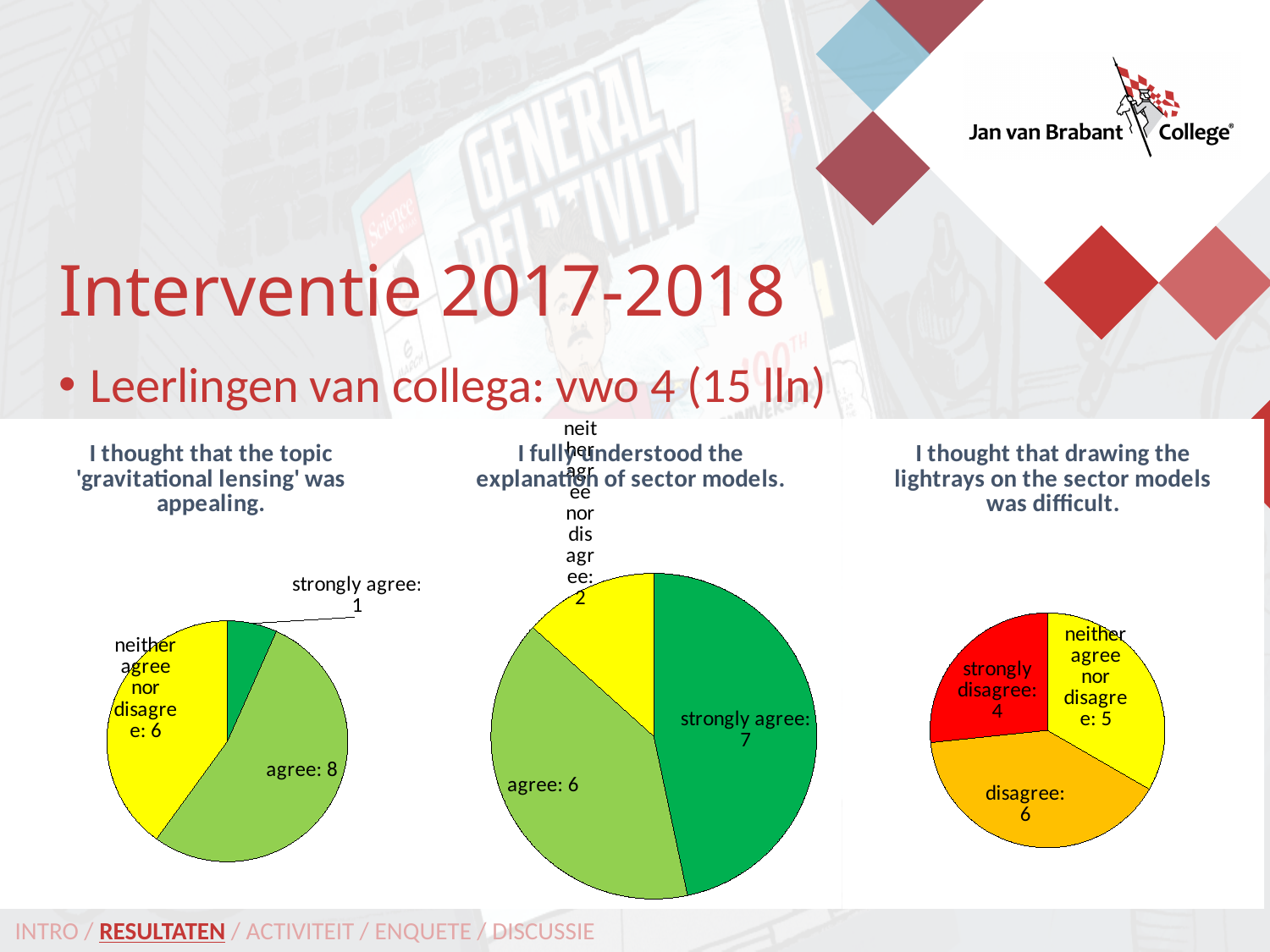
In the chart titled "I thought that the topic 'gravitational lensing' was appealing.", how many students answered "agree"? 8 In the chart titled "I thought that drawing the lightrays on the sector models was difficult.", how many students answered "disagree"? 6 In the chart titled "I thought that the topic 'gravitational lensing' was appealing.", which response has the smallest slice? strongly agree In the chart titled "I thought that the topic 'gravitational lensing' was appealing.", what is the difference between the "agree" and "neither agree nor disagree" counts? 2 In the chart titled "I thought that drawing the lightrays on the sector models was difficult.", which is larger: "strongly disagree" or "neither agree nor disagree"? neither agree nor disagree In the chart titled "I fully understood the explanation of sector models.", which response has the largest slice? strongly agree In the chart titled "I fully understood the explanation of sector models.", how many students answered "strongly agree"? 7 In the chart titled "I fully understood the explanation of sector models.", how many students answered "neither agree nor disagree"? 2 What kind of chart is used for "I fully understood the explanation of sector models."? pie chart In the chart titled "I thought that drawing the lightrays on the sector models was difficult.", what colour is the "strongly disagree" slice? red How many slices does the chart titled "I thought that drawing the lightrays on the sector models was difficult." have? 3 In the chart titled "I thought that drawing the lightrays on the sector models was difficult.", what is the difference between the "disagree" and "strongly disagree" counts? 2